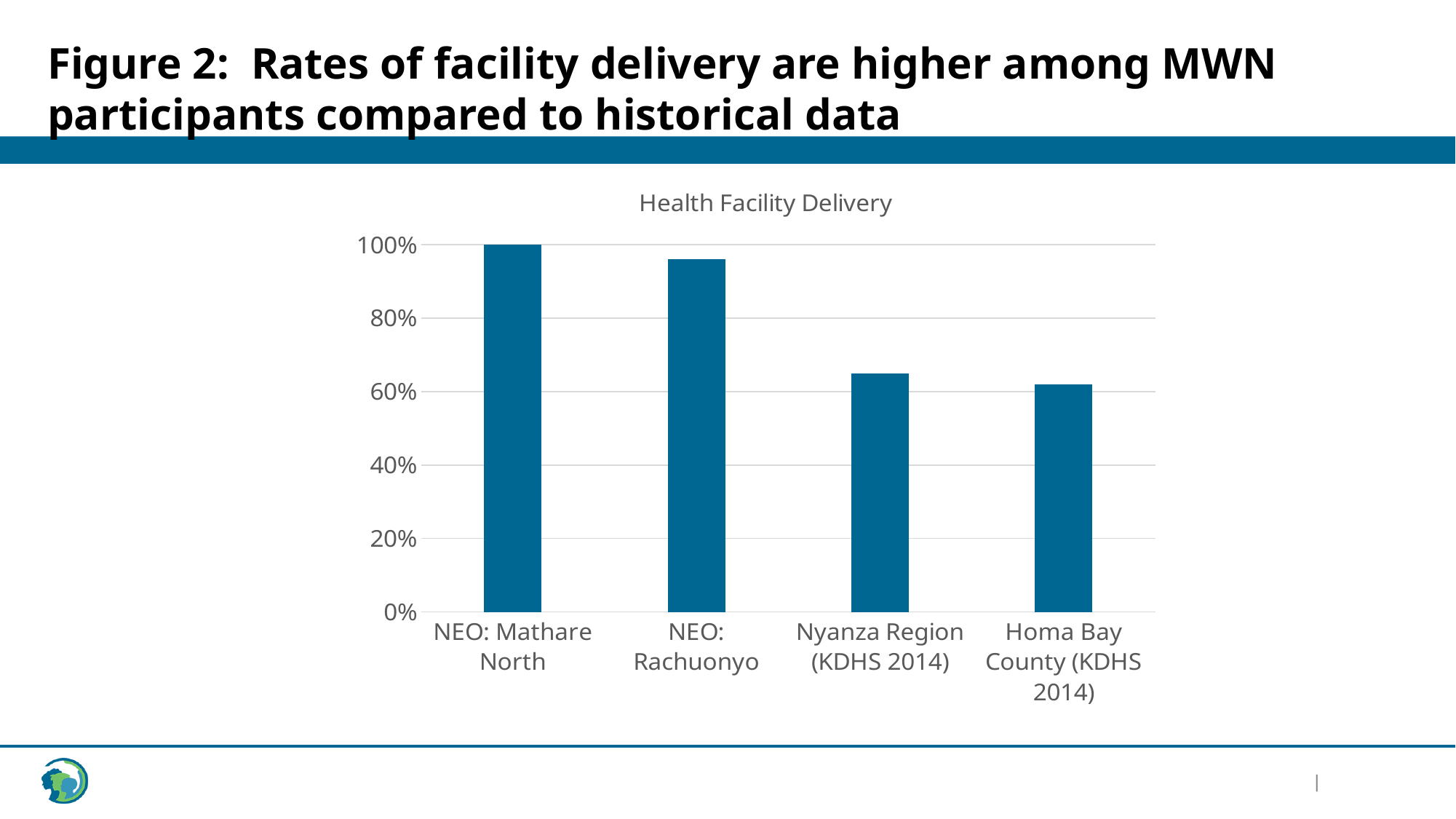
Do the values rise or fall from left to right along the x axis? fall What is the title of the chart? Health Facility Delivery Which is larger, the value for NEO: Rachuonyo or the value for Nyanza Region (KDHS 2014)? NEO: Rachuonyo Is the value for Homa Bay County (KDHS 2014) greater or less than 40%? greater Is the value for Nyanza Region (KDHS 2014) greater or less than 80%? less Which category has the highest value? NEO: Mathare North How many categories are shown on the x axis? 4 What is the highest value shown on the y axis? 100% What is the value for NEO: Mathare North? 100% Which is larger, the value for NEO: Mathare North or the value for Homa Bay County (KDHS 2014)? NEO: Mathare North Is the value for NEO: Rachuonyo greater or less than 80%? greater What kind of chart is shown on the slide? bar chart